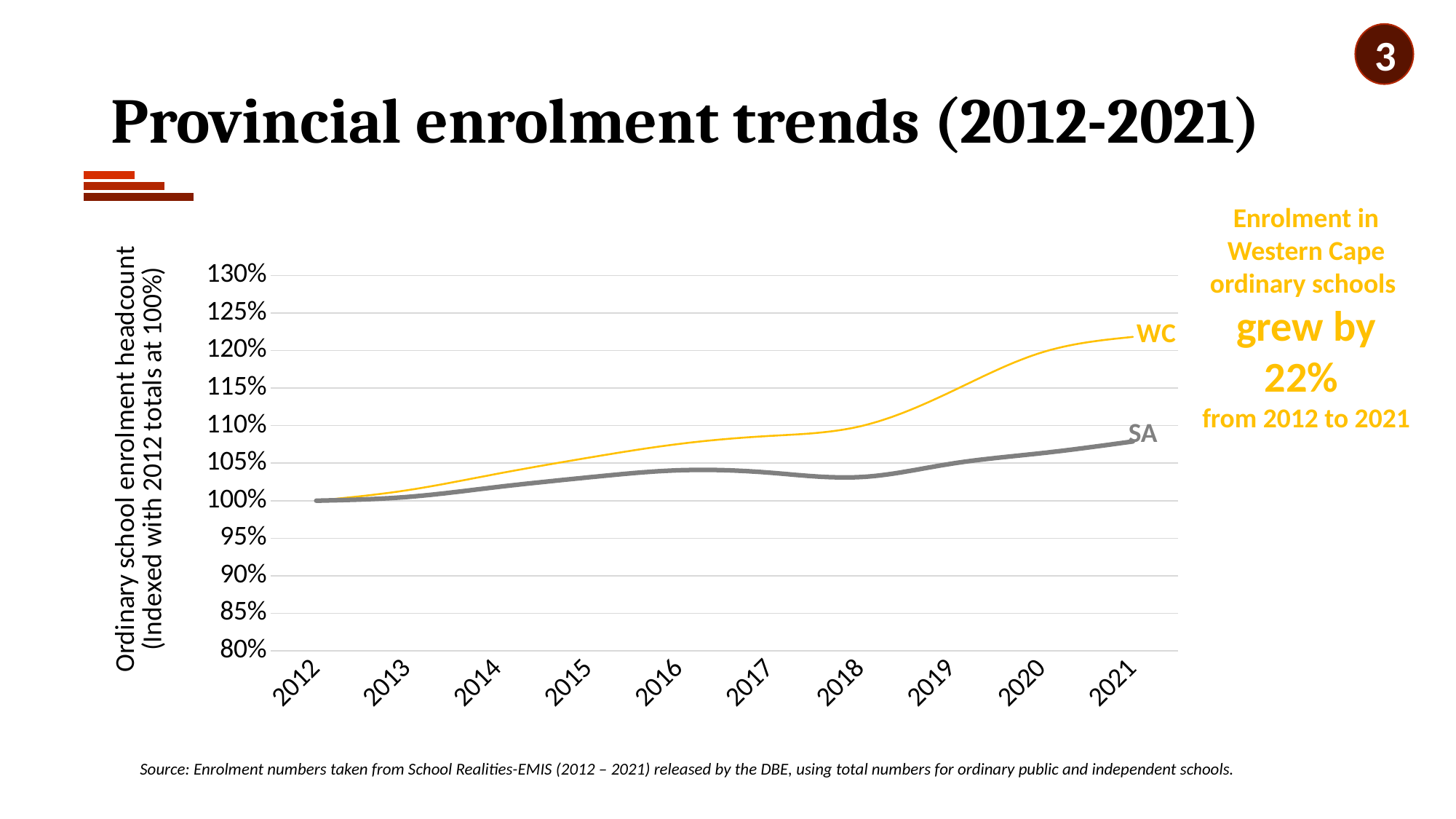
What is the indexed enrolment value for WC in 2012? 100% Is the value for SA in 2021 greater or less than 110%? less Is the value for WC in 2019 greater or less than 110%? greater How many years are shown along the x axis of the chart? 10 What is the indexed enrolment value for SA in 2012? 100% Is the value for WC in 2021 greater or less than 120%? greater Does the WC line rise or fall from 2012 to 2021? rise According to the slide text, by what percentage did enrolment in Western Cape ordinary schools grow from 2012 to 2021? 22% What kind of chart is shown on the slide? line chart How many series are plotted on the chart? 2 Which series has the higher value in 2021, WC or SA? WC